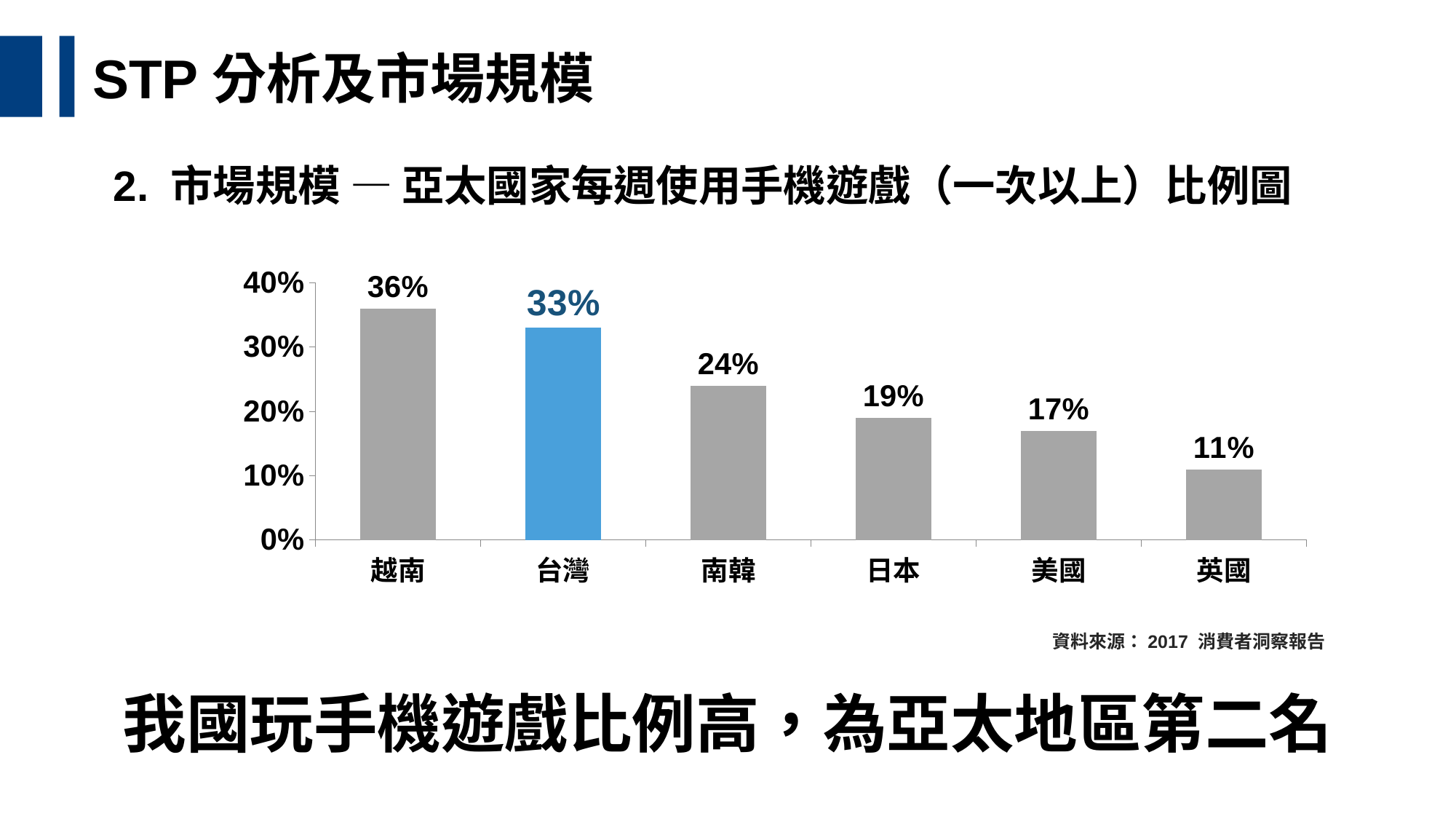
What is the value for 越南? 36% What is the difference between the values for 越南 and 台灣? 3% What is the value for 日本? 19% Which category has the highest value? 越南 Which bar is highlighted in blue rather than grey? 台灣 What kind of chart is shown on the slide? Bar chart What is the value for 英國? 11% Which category has the lowest value? 英國 Which is larger, the value for 美國 or the value for 日本? 日本 How many categories are shown on the x axis? 6 What is the value for 台灣? 33% What is the value for 南韓? 24%